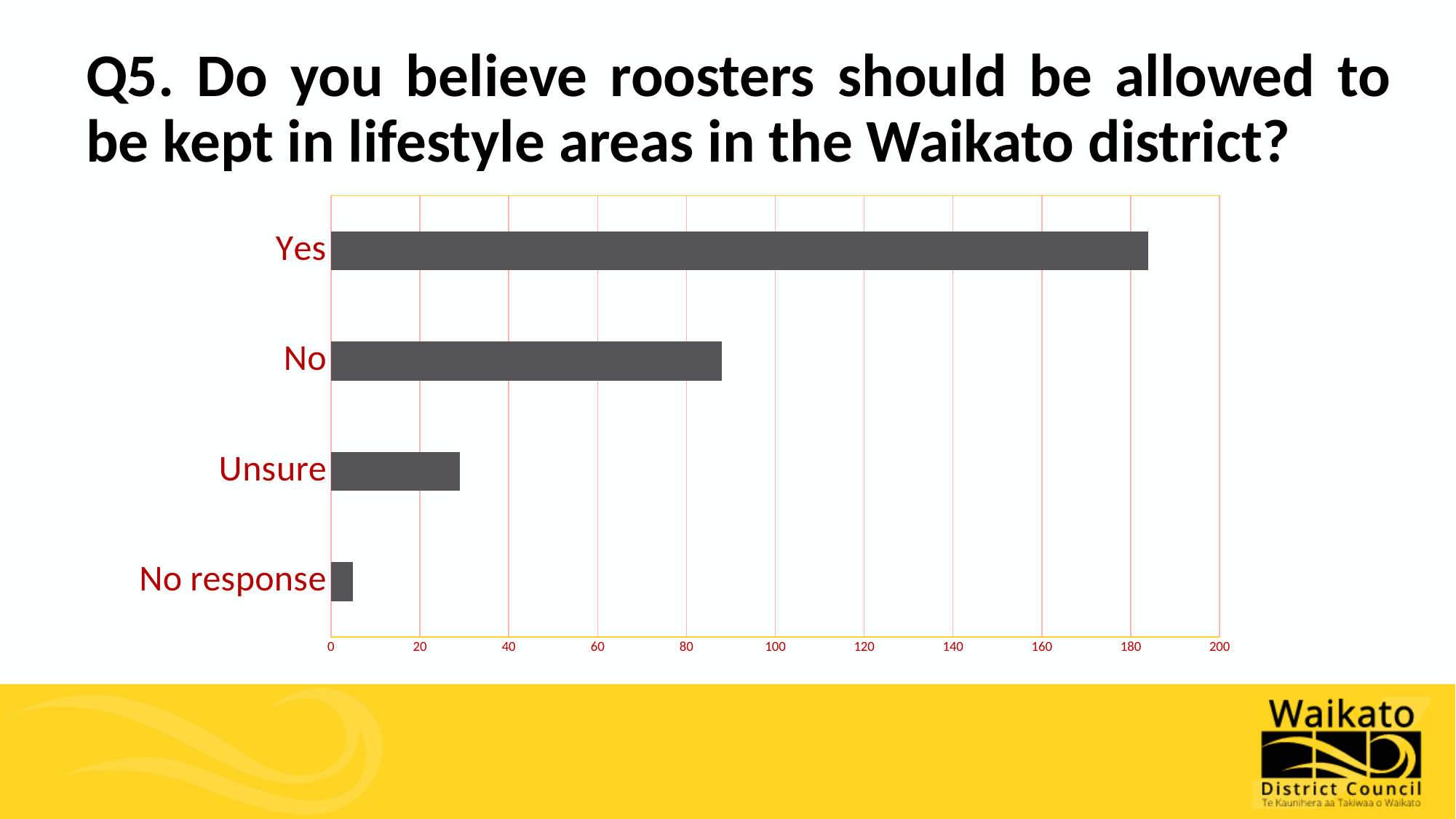
Which is larger, the value for Yes or the value for No? Yes Which category has the lowest value? No response Is the value for No greater or less than 100? less Is the value for Unsure greater or less than 20? greater What is the highest value shown on the horizontal axis? 200 Which category has the highest value? Yes Is the value for Yes greater or less than 180? greater Which is larger, the value for Unsure or the value for No response? Unsure How many categories are plotted in the chart? 4 What kind of chart is shown on the slide? bar chart What question does the chart's title ask? Q5. Do you believe roosters should be allowed to be kept in lifestyle areas in the Waikato district?